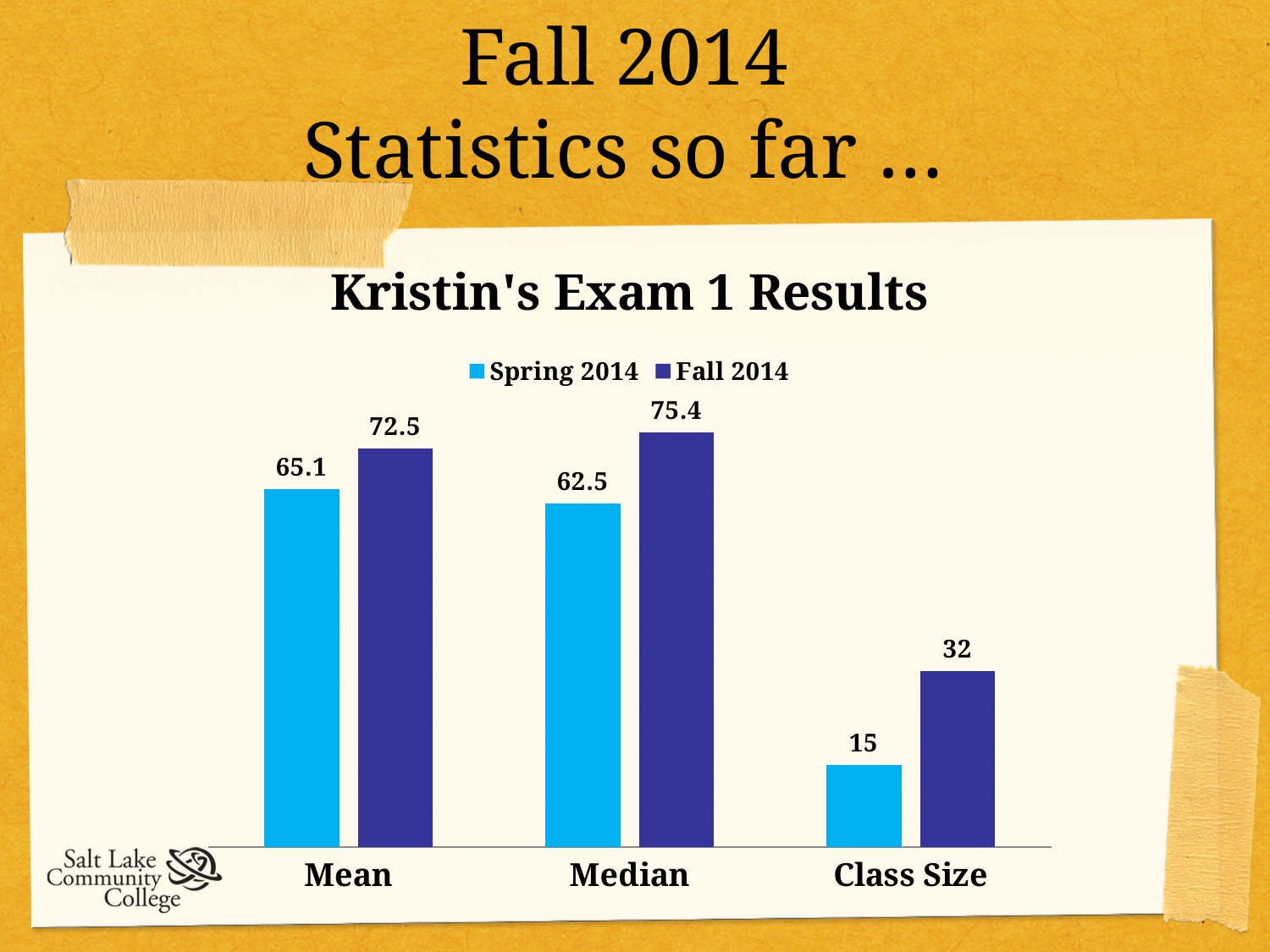
What is the Spring 2014 value for Mean? 65.1 What is the difference between the Fall 2014 and Spring 2014 values for Mean? 7.4 How many categories are shown on the x axis? 3 What is the Fall 2014 value for Mean? 72.5 Which category has the highest Fall 2014 value? Median What is the Fall 2014 value for Class Size? 32 What is the difference between the Fall 2014 and Spring 2014 values for Class Size? 17 What kind of chart is shown? Bar chart How many series does the legend list? 2 Which is larger, the Spring 2014 Median or the Fall 2014 Median? Fall 2014 Median Which category has the lowest Spring 2014 value? Class Size What is the Spring 2014 value for Median? 62.5